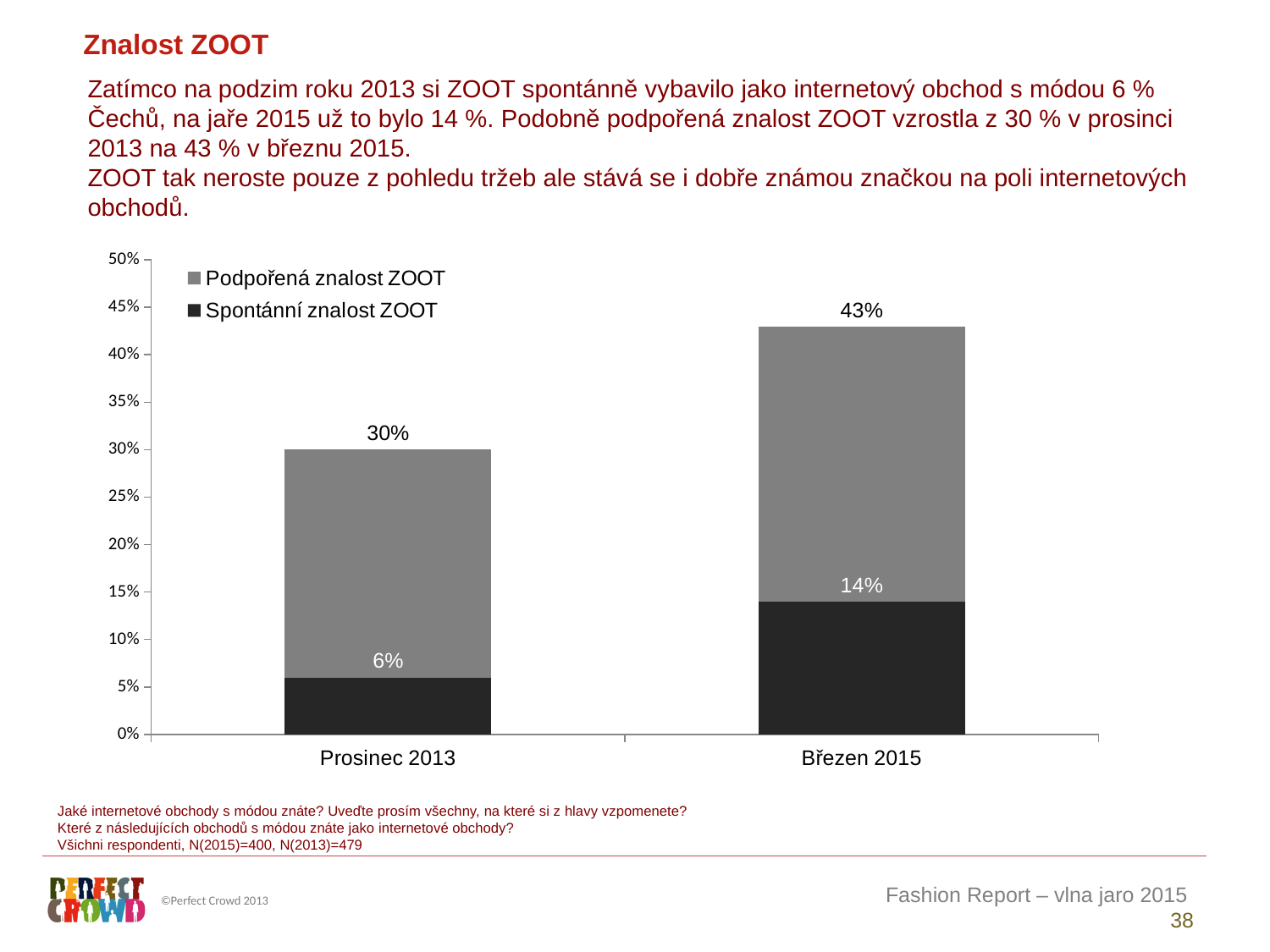
Which period has the higher Spontánní znalost ZOOT, Prosinec 2013 or Březen 2015? Březen 2015 Do the values for Podpořená znalost ZOOT rise or fall from Prosinec 2013 to Březen 2015? rise What is the value of Podpořená znalost ZOOT for Prosinec 2013? 30% What is the value of Spontánní znalost ZOOT for Prosinec 2013? 6% How many series does the chart legend list? 2 By how many percentage points did Podpořená znalost ZOOT increase from Prosinec 2013 to Březen 2015? 13 percentage points What kind of chart is shown on the slide? bar chart How many periods are shown on the x axis of the chart? 2 Is the value of Podpořená znalost ZOOT for Březen 2015 greater or less than 40%? greater What is the value of Spontánní znalost ZOOT for Březen 2015? 14% What is the value of Podpořená znalost ZOOT for Březen 2015? 43% By how many percentage points did Spontánní znalost ZOOT increase from Prosinec 2013 to Březen 2015? 8 percentage points